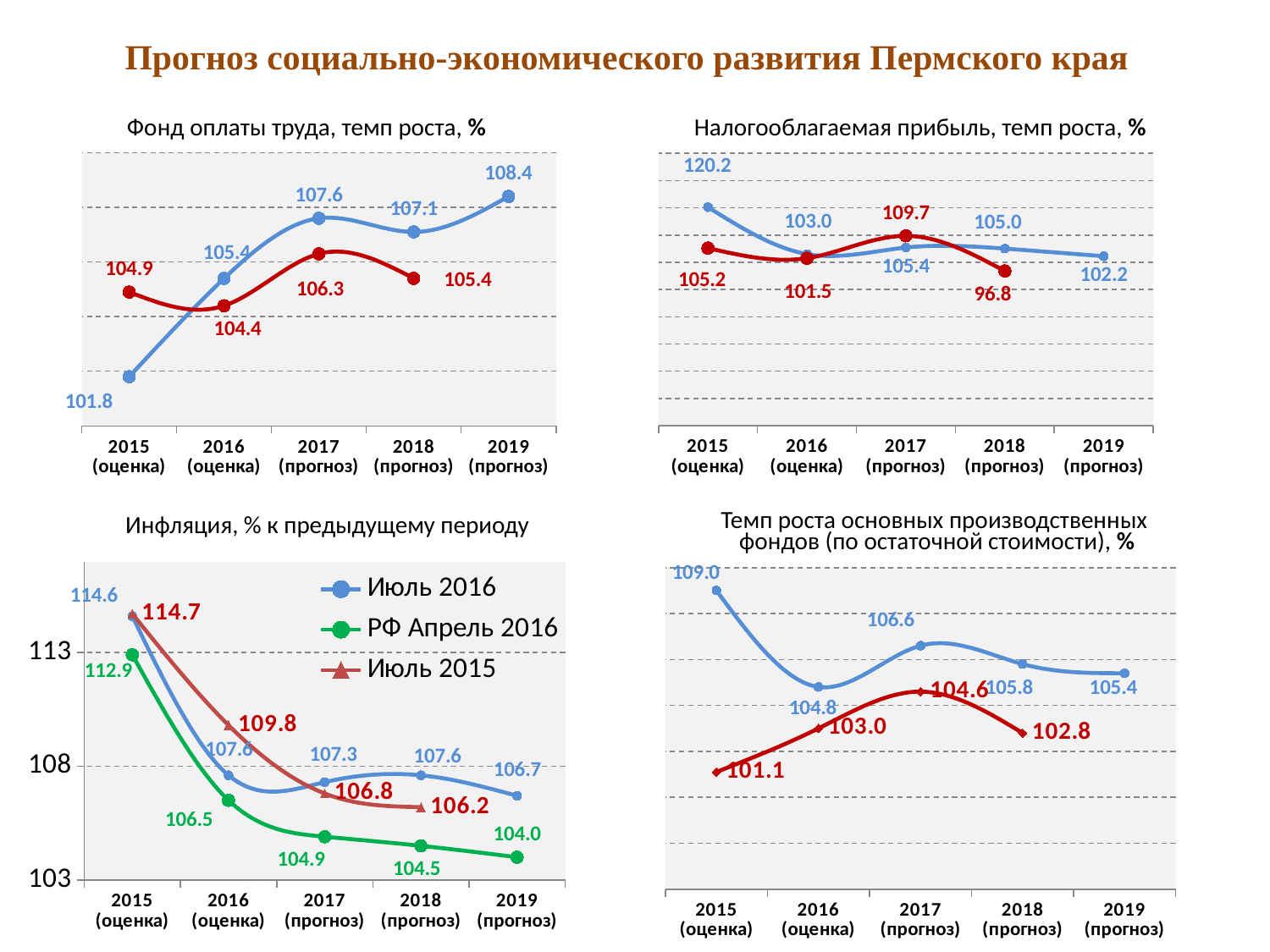
In the chart 'Инфляция, % к предыдущему периоду', what is the value of 'Июль 2015' for 2016 (оценка)? 109.8 In the chart 'Налогооблагаемая прибыль, темп роста, %', what is the lowest value on the red line? 96.8 In the chart 'Инфляция, % к предыдущему периоду', what is the value of 'РФ Апрель 2016' for 2019 (прогноз)? 104.0 In the chart 'Темп роста основных производственных фондов (по остаточной стоимости), %', is the red line's value higher in 2017 (прогноз) or 2018 (прогноз)? 2017 (прогноз) In the chart 'Фонд оплаты труда, темп роста, %', what is the value of the blue line for 2019 (прогноз)? 108.4 How many series does the legend of the chart 'Инфляция, % к предыдущему периоду' list? 3 In the chart 'Темп роста основных производственных фондов (по остаточной стоимости), %', what is the value of the blue line for 2015 (оценка)? 109.0 What kind of chart is 'Фонд оплаты труда, темп роста, %'? line chart In the chart 'Налогооблагаемая прибыль, темп роста, %', in which year does the blue line reach its highest value? 2015 (оценка) In the chart 'Фонд оплаты труда, темп роста, %', what is the value of the red line for 2016 (оценка)? 104.4 In the chart 'Налогооблагаемая прибыль, темп роста, %', what is the difference between the blue line's values for 2015 (оценка) and 2019 (прогноз)? 18.0 In the chart 'Инфляция, % к предыдущему периоду', does the 'РФ Апрель 2016' line rise or fall from 2015 to 2019? fall